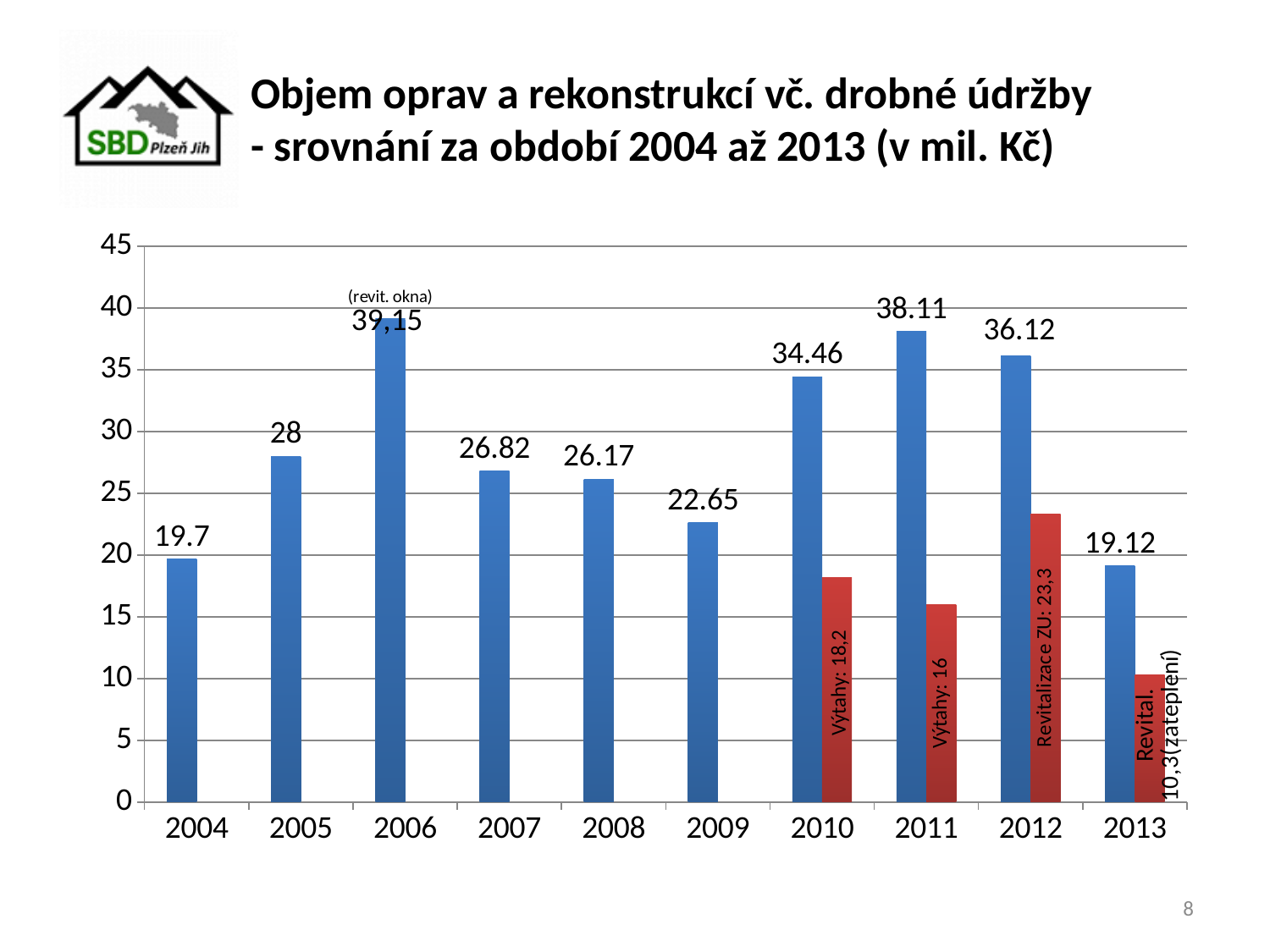
Is the value of the blue bar for 2010 greater or less than 30? greater Which is larger, the blue bar for 2007 or the blue bar for 2008? 2007 What is the value of the blue bar for 2011? 38.11 What kind of chart is shown on the slide? bar chart How many years are shown on the x axis? 10 Do the blue bar values rise or fall from 2011 to 2013? fall What is the value of the blue bar for 2004? 19.7 What is the difference between the blue bar values for 2011 and 2012? 1.99 Which year has the highest blue bar? 2006 What is the value of the blue bar for 2009? 22.65 Which year has the lowest blue bar? 2013 What value is labelled on the red bar for 2012 (Revitalizace ZU)? 23,3